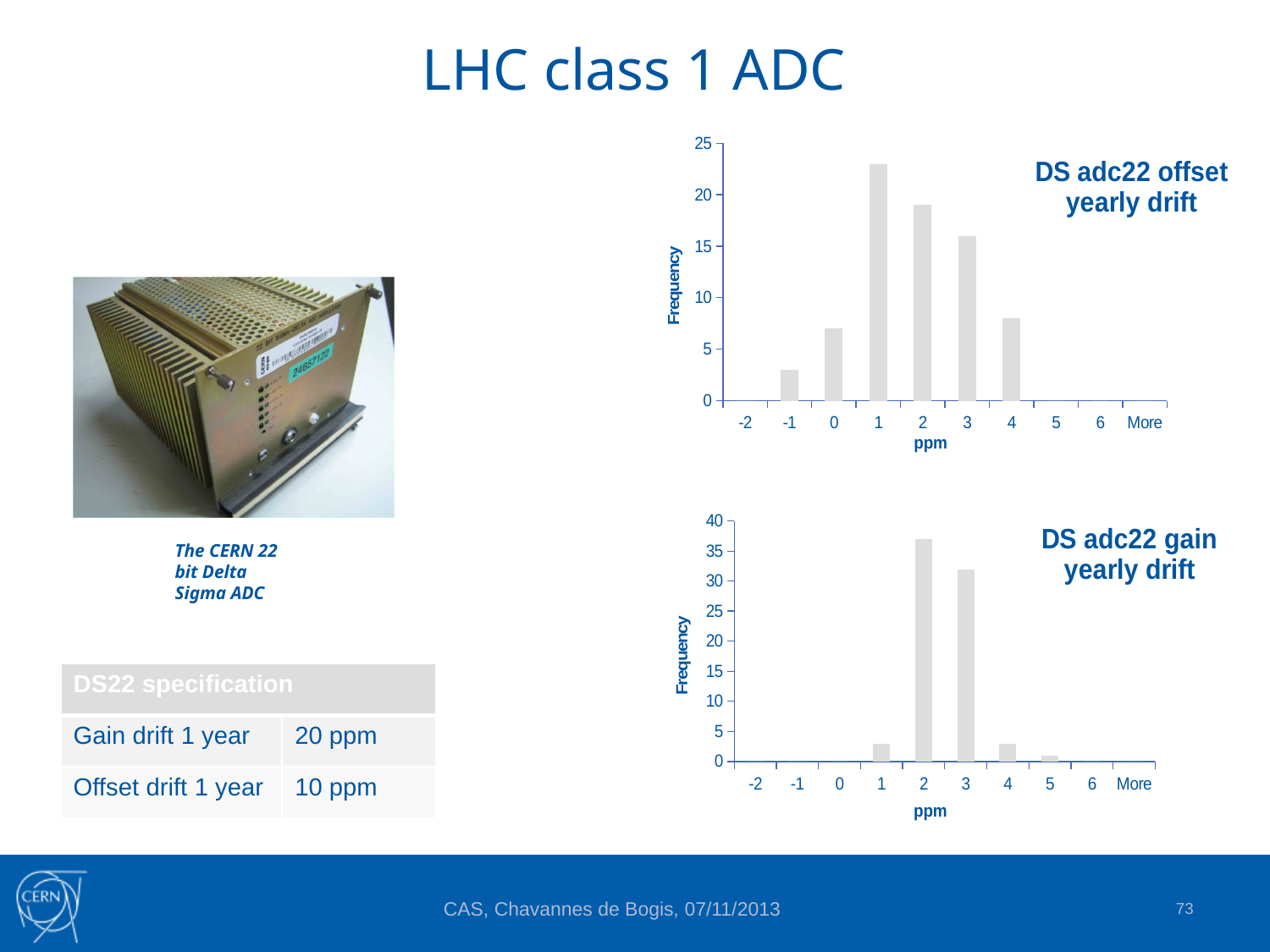
In the 'DS adc22 offset yearly drift' chart, which ppm bin has the highest frequency? 1 What type of chart is the 'DS adc22 gain yearly drift' chart? Bar chart In the 'DS adc22 offset yearly drift' chart, is the frequency for the -1 ppm bin greater or less than 5? less In the 'DS adc22 gain yearly drift' chart, is the frequency for the 3 ppm bin greater or less than 30? greater In the 'DS adc22 offset yearly drift' chart, is the frequency for the 0 ppm bin greater or less than 5? greater In the 'DS adc22 gain yearly drift' chart, which ppm bin has the highest frequency? 2 In the 'DS adc22 gain yearly drift' chart, which bin has the higher frequency, 2 ppm or 3 ppm? 2 ppm In the 'DS adc22 offset yearly drift' chart, which bin has the higher frequency, 2 ppm or 3 ppm? 2 ppm How many bins are labelled on the x axis of the 'DS adc22 offset yearly drift' chart? 10